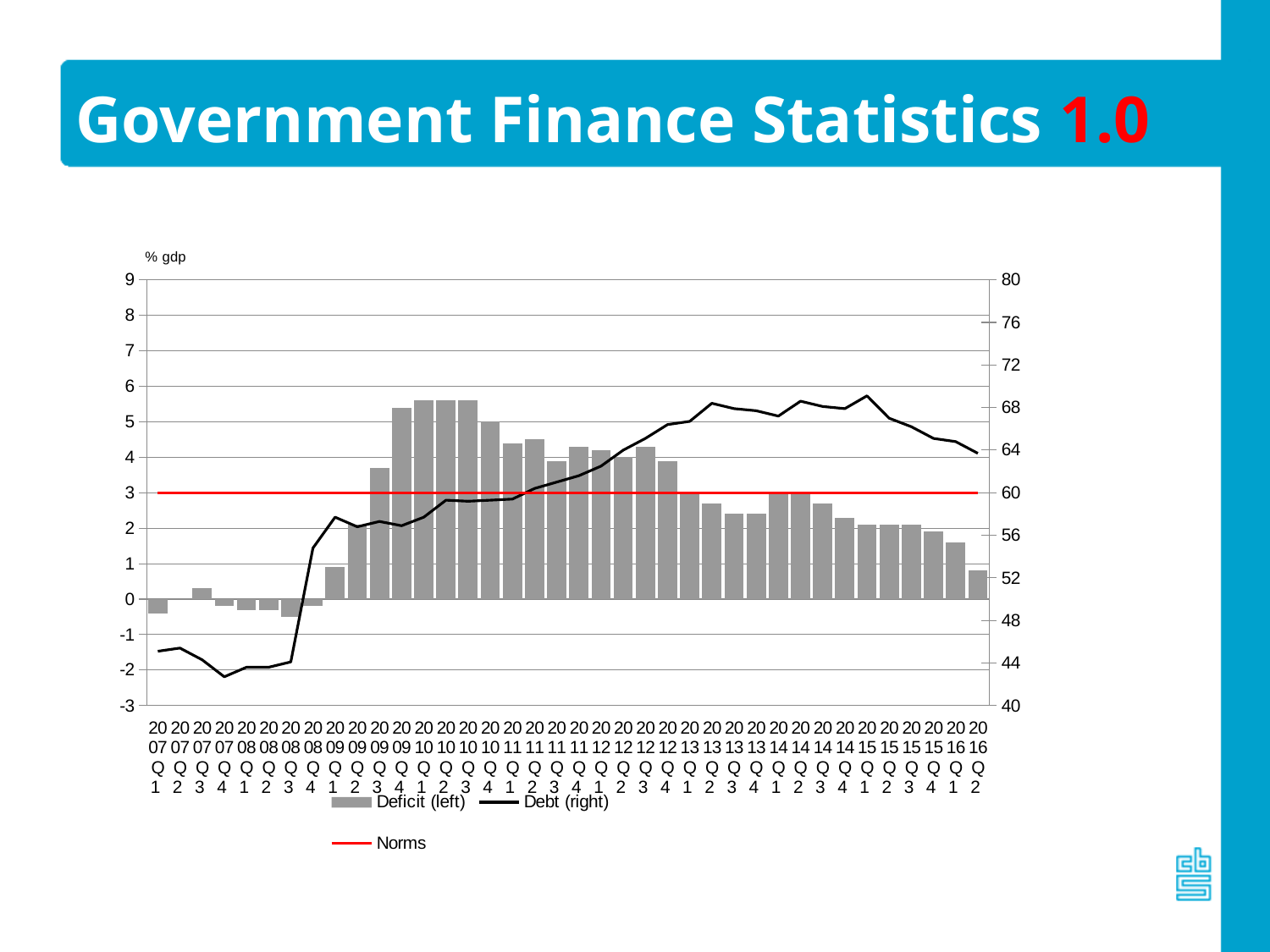
How many quarters are plotted along the x axis? 38 Which series is plotted against the right-hand axis? Debt Which is larger, the Deficit bar for 2010 Q2 or the Deficit bar for 2014 Q1? 2010 Q2 Is the Debt value for 2007 Q1 greater or less than 48? less In which quarter is the Debt line at its lowest? 2007 Q4 How many series does the legend list? 3 Does the Debt line rise or fall between 2008 Q3 and 2013 Q1? Rises Is the Debt value for 2016 Q2 greater or less than 60? greater In which quarter does the Debt line reach its highest point? 2015 Q1 What kind of chart is shown on the slide? A combined bar and line chart Is the Deficit bar for 2010 Q1 greater or less than 5? greater At what value on the left axis does the red Norms line sit? 3